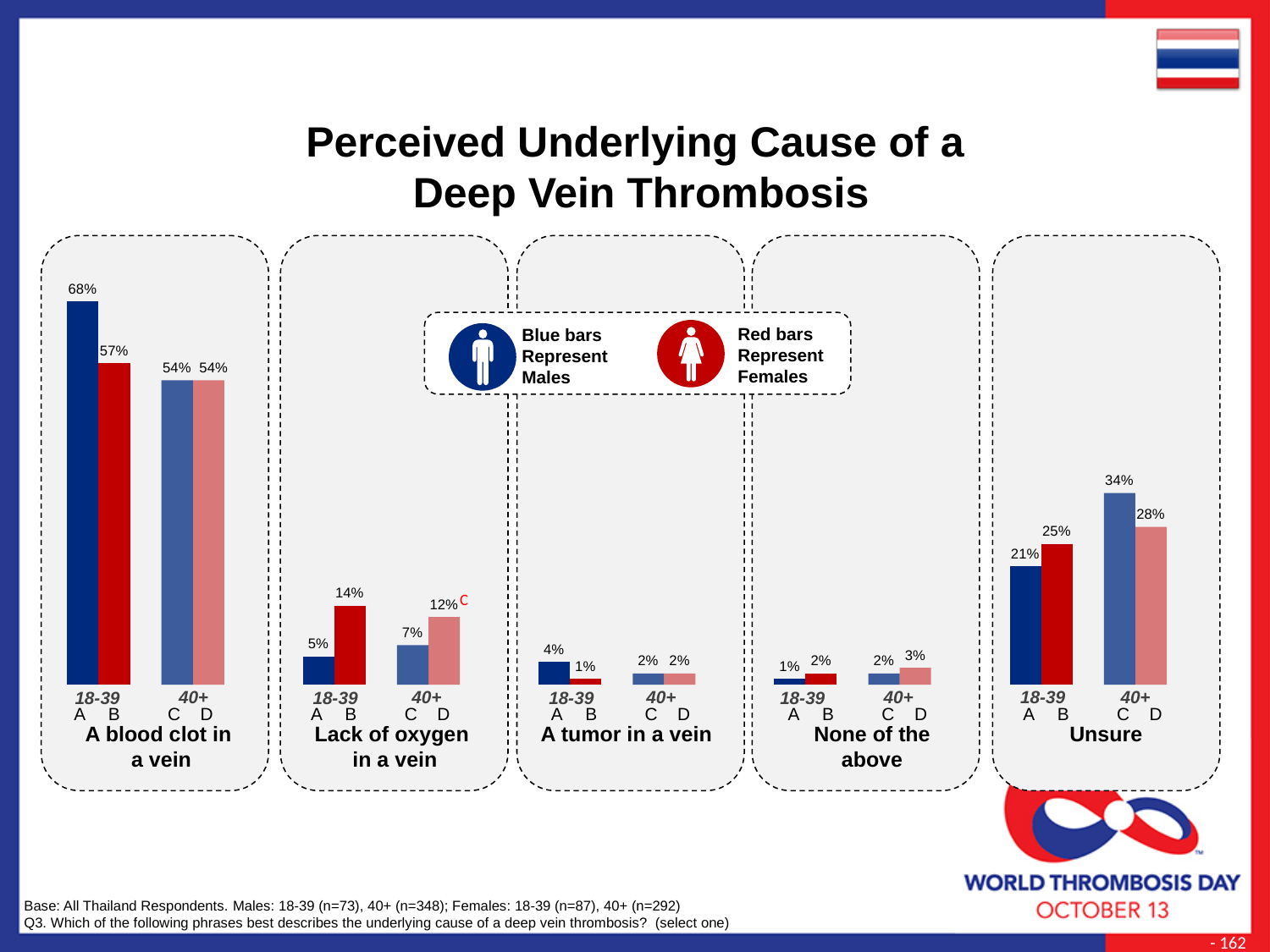
According to the legend, what do the red bars represent? Females In the 'A tumor in a vein' panel, what is the value for males aged 18-39 (bar A)? 4% In the 'A blood clot in a vein' panel, what is the difference between bar A (68%) and bar B (57%)? 11 percentage points In the 'Unsure' panel, which bar is the highest? C (males 40+) In the 'Lack of oxygen in a vein' panel, which bar is the lowest? A (males 18-39) In the 'A blood clot in a vein' panel, what is the value for males aged 18-39 (bar A)? 68% In the 'A blood clot in a vein' panel, what is the value for females aged 18-39 (bar B)? 57% How many bars are shown in each panel of the chart? 4 In the 'Unsure' panel, what is the value for males aged 40+ (bar C)? 34% In the 'Lack of oxygen in a vein' panel, what is the value for females aged 40+ (bar D)? 12% In the 'Unsure' panel, what is the difference between bar C (34%) and bar D (28%)? 6 percentage points In the 'Lack of oxygen in a vein' panel, which is larger: bar B (females 18-39) or bar D (females 40+)? Bar B (14%)